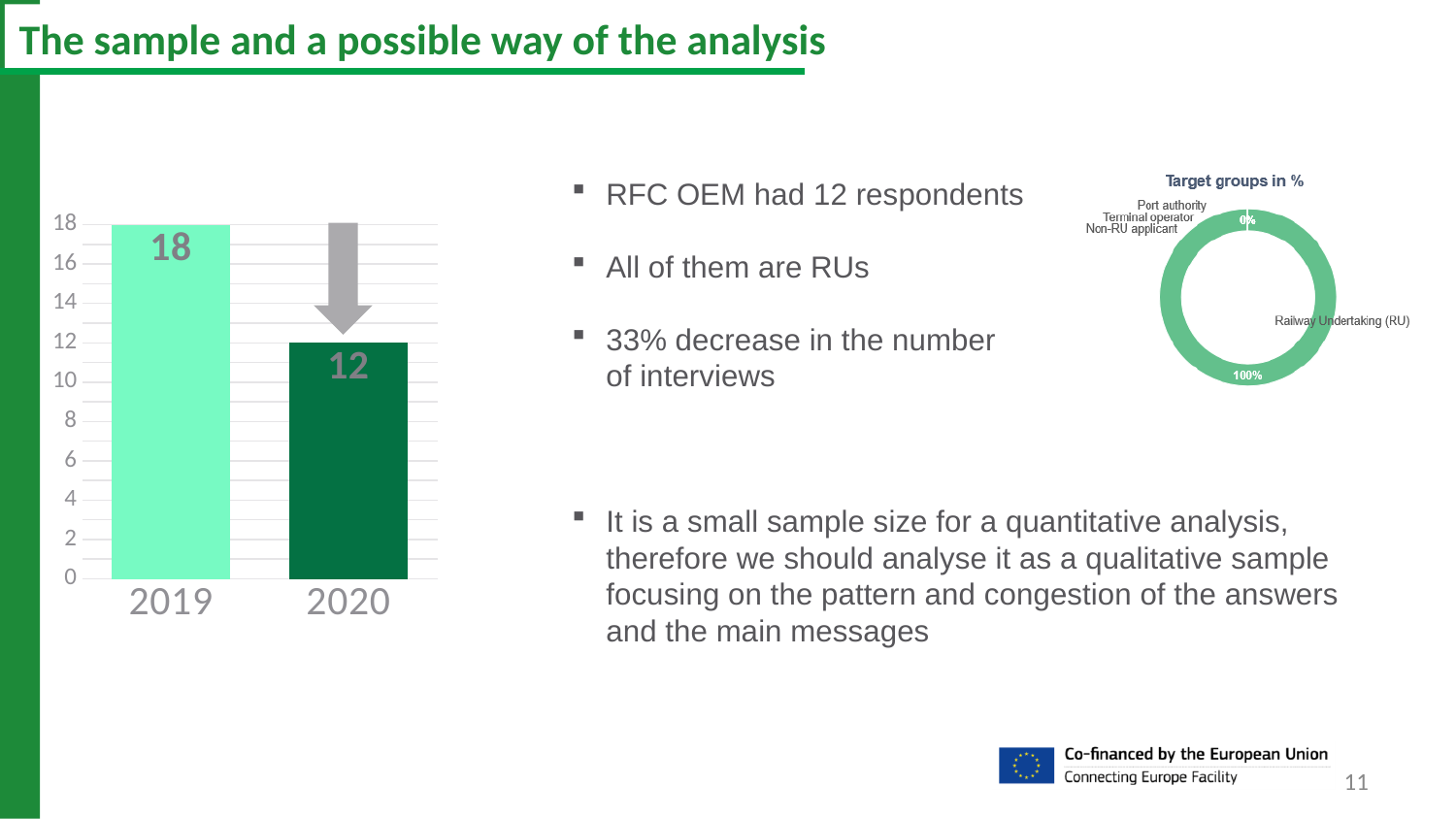
In the 'Target groups in %' chart, what share is shown for Railway Undertaking (RU)? 100% In the bar chart on the left, is the value for 2020 greater or less than 14? less In the bar chart on the left, what is the value for 2020? 12 In the bar chart on the left, do the values rise or fall from 2019 to 2020? fall In the bar chart on the left, what is the difference between the 2019 and 2020 values? 6 In the bar chart on the left, what is the value for 2019? 18 What kind of chart is shown on the left of the slide? bar chart What is the title of the chart on the right of the slide? Target groups in % How many bars are shown in the bar chart on the left? 2 In the bar chart on the left, which year has the higher value? 2019 What kind of chart is the 'Target groups in %' chart? doughnut chart In the bar chart on the left, which year has the lower value? 2020